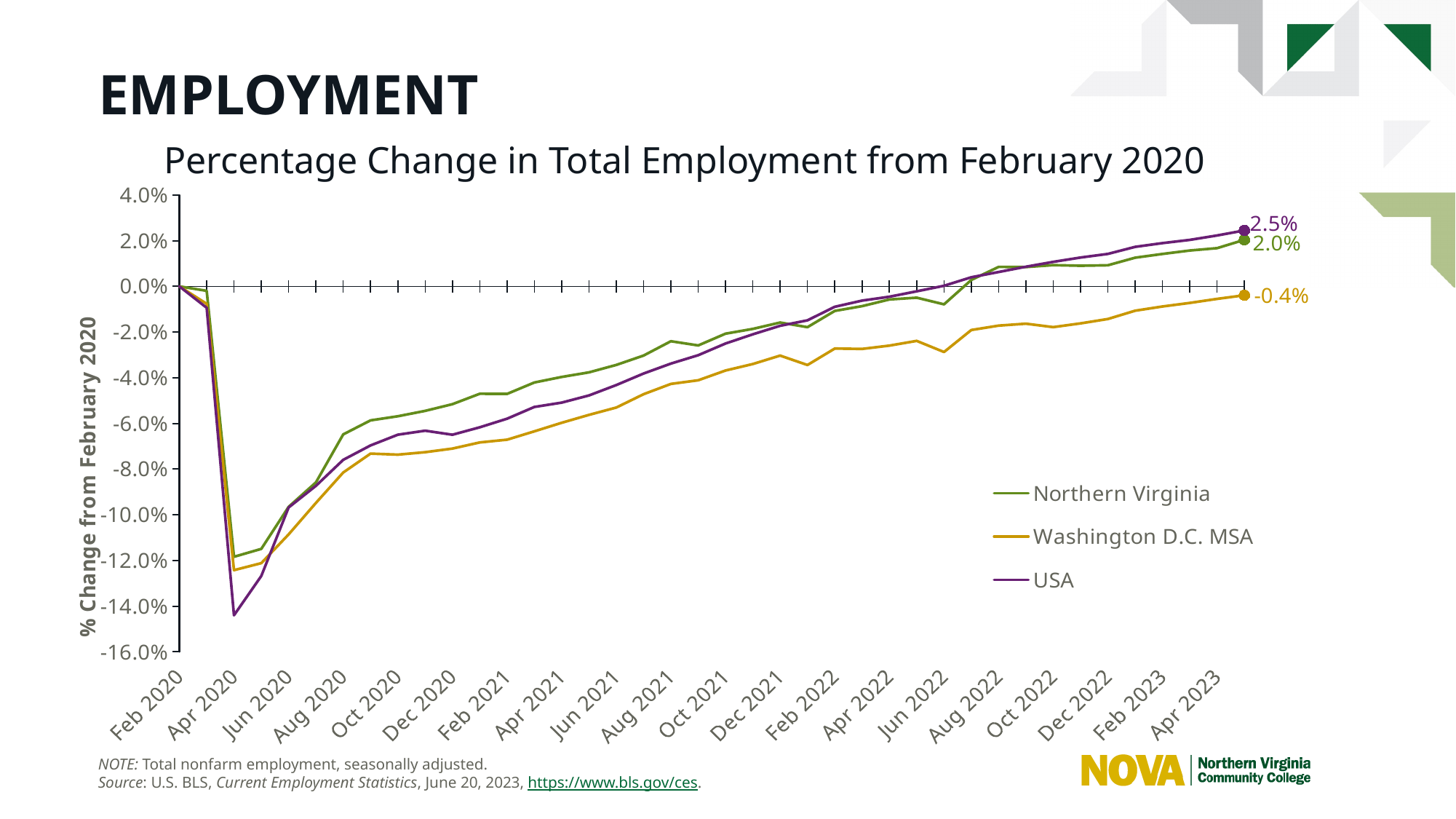
Which series dropped lower in Apr 2020, USA or Northern Virginia? USA Which series has the highest value at the end of the chart? USA What is the title of the chart? Percentage Change in Total Employment from February 2020 How many series does the legend list? 3 What kind of chart is shown on the slide? Line chart What is the labelled value at the end of the USA line? 2.5% Which series has the lowest value at the end of the chart? Washington D.C. MSA Is the value for USA in Apr 2020 greater or less than -12.0%? less What is the labelled value at the end of the Northern Virginia line? 2.0% What is the labelled value at the end of the Washington D.C. MSA line? -0.4% What is the difference between the final labelled values for USA and Northern Virginia? 0.5% What is the difference between the final labelled values for Northern Virginia and Washington D.C. MSA? 2.4%